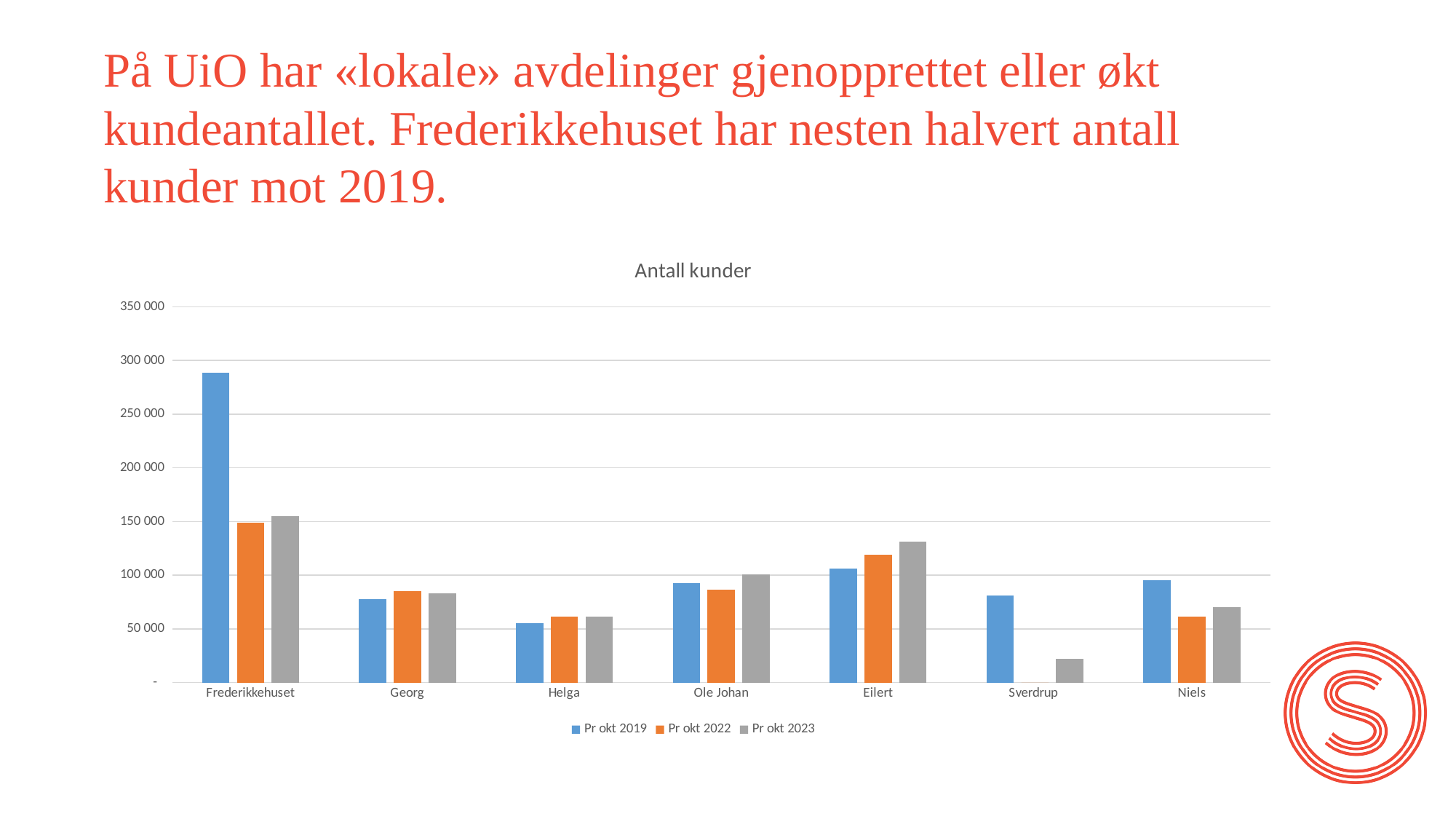
Which category has the lowest value for Pr okt 2019? Helga For Frederikkehuset, which is larger: the Pr okt 2019 value or the Pr okt 2023 value? Pr okt 2019 Is the Pr okt 2019 value for Frederikkehuset greater or less than 250 000? greater Is the Pr okt 2023 value for Sverdrup greater or less than 50 000? less Which category has the highest value for Pr okt 2019? Frederikkehuset Which category has the lowest value for Pr okt 2023? Sverdrup How many categories are shown on the x axis of the chart? 7 How many series does the chart's legend list? 3 For Pr okt 2023, which is larger: Eilert or Ole Johan? Eilert What kind of chart is shown on the slide? bar chart What is the title of the chart? Antall kunder Is the Pr okt 2023 value for Eilert greater or less than 100 000? greater